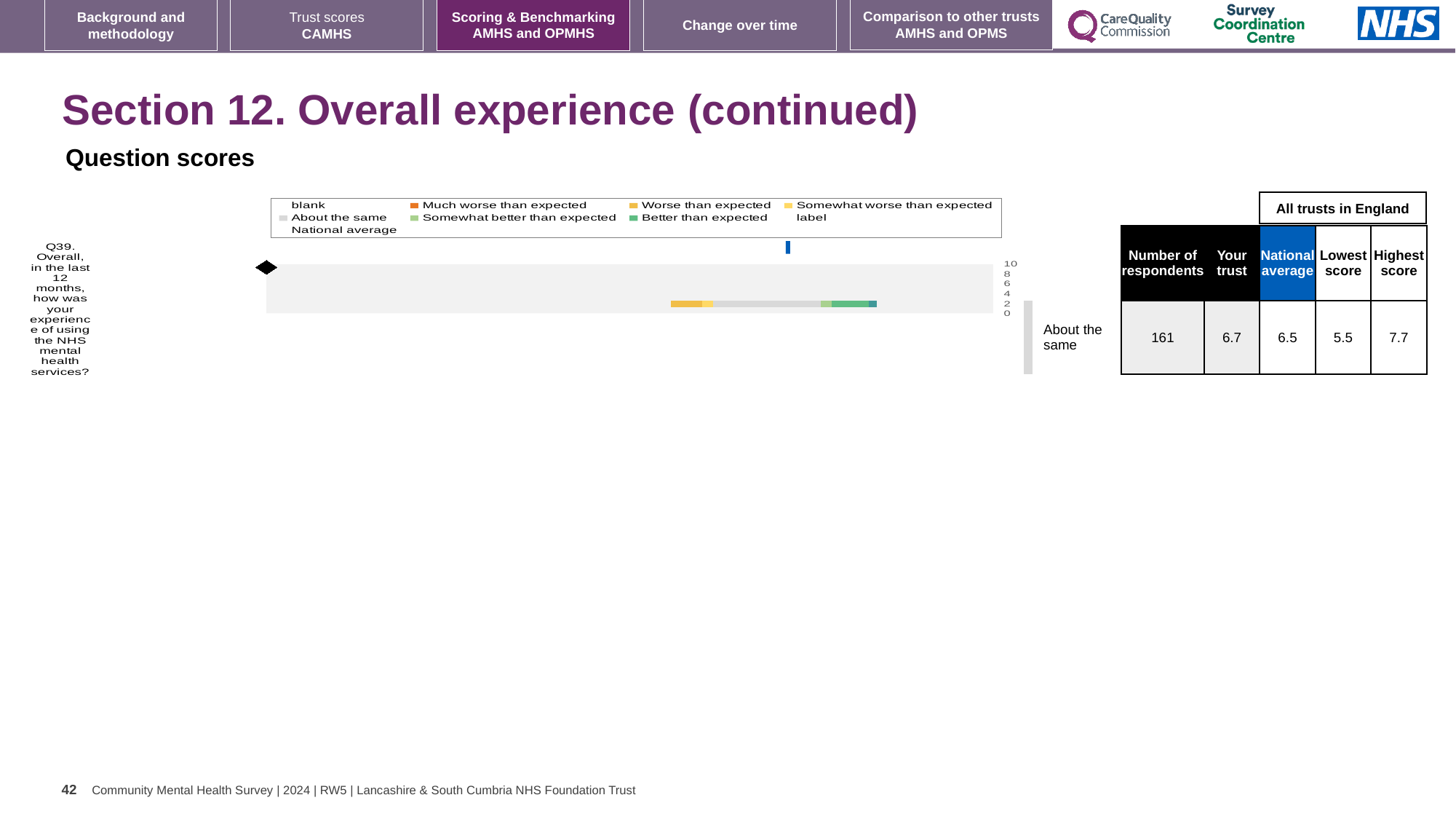
What is the difference between the highest score (7.7) and the lowest score (5.5) for Q39 across all trusts in England? 2.2 What kind of chart is shown on the slide for Q39? Bar chart How many entries does the chart legend list? 9 According to the table beside the chart, what is the 'Your trust' score for Q39? 6.7 Which benchmark category is the trust's Q39 score placed in, as labelled next to the chart? About the same What is the lowest score for Q39 among all trusts in England? 5.5 How many survey questions are plotted in the chart on this slide? 1 According to the table beside the chart, what is the national average score for Q39? 6.5 For Q39, which is higher: the trust's score or the national average? The trust's score Which question number is plotted in the chart? Q39 How many respondents answered Q39 for this trust? 161